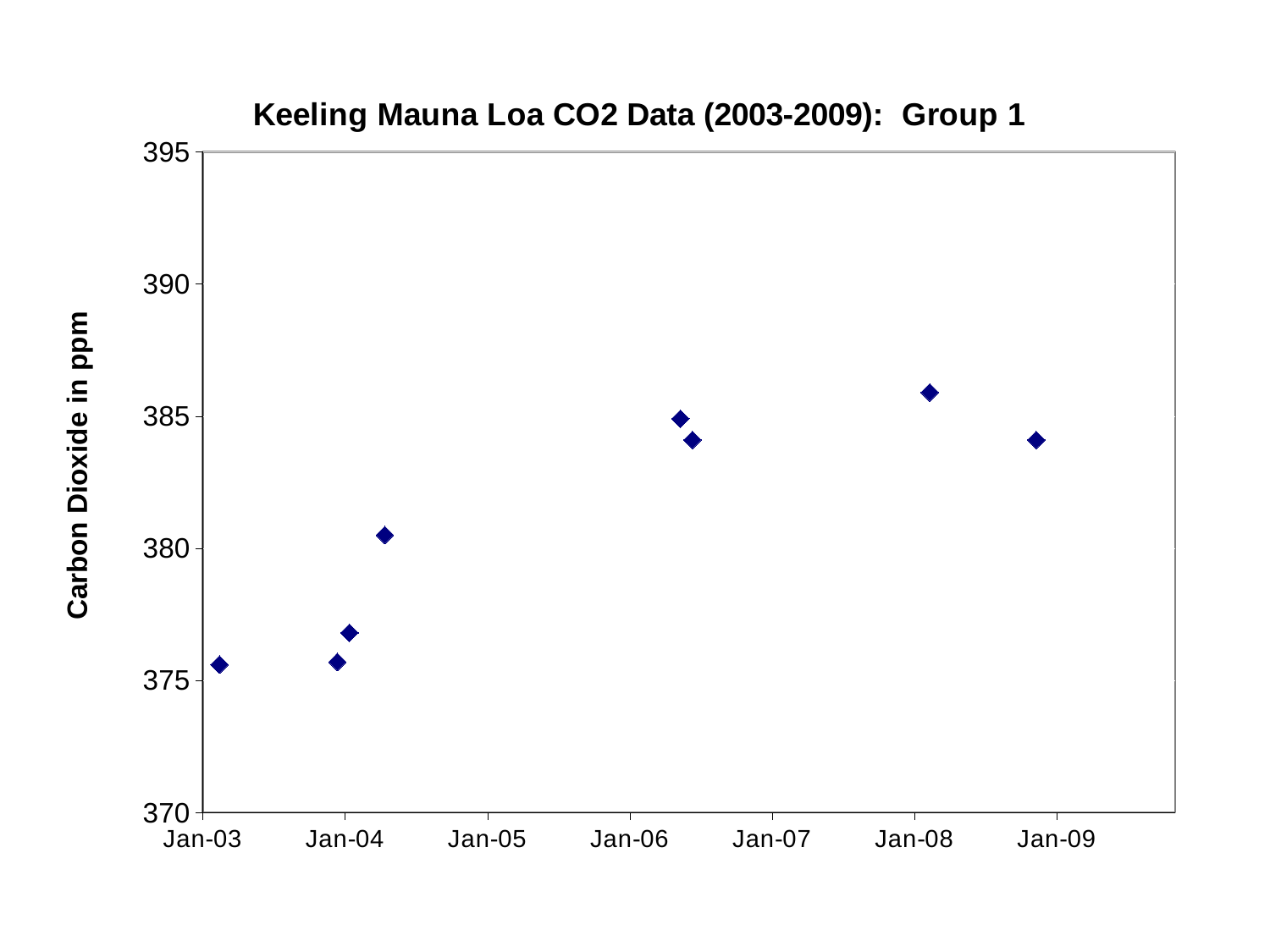
Is the value of the highest point near Jan-08 greater or less than 385? greater How many data points are plotted on the chart? 8 What kind of chart is shown on the slide? scatter plot Is the value of the point just before Jan-09 greater or less than 380? greater What is the label on the vertical axis? Carbon Dioxide in ppm Around which x-axis label does the highest plotted point appear? Jan-08 What is the title of the chart? Keeling Mauna Loa CO2 Data (2003-2009): Group 1 Do the CO2 values generally rise or fall from Jan-03 to Jan-09? rise How many year labels are shown on the x axis? 7 Is the value of the point just before Jan-09 greater or less than 385? less Which point has the highest CO2 value: the one at Jan-03 or the one near Jan-08? the one near Jan-08